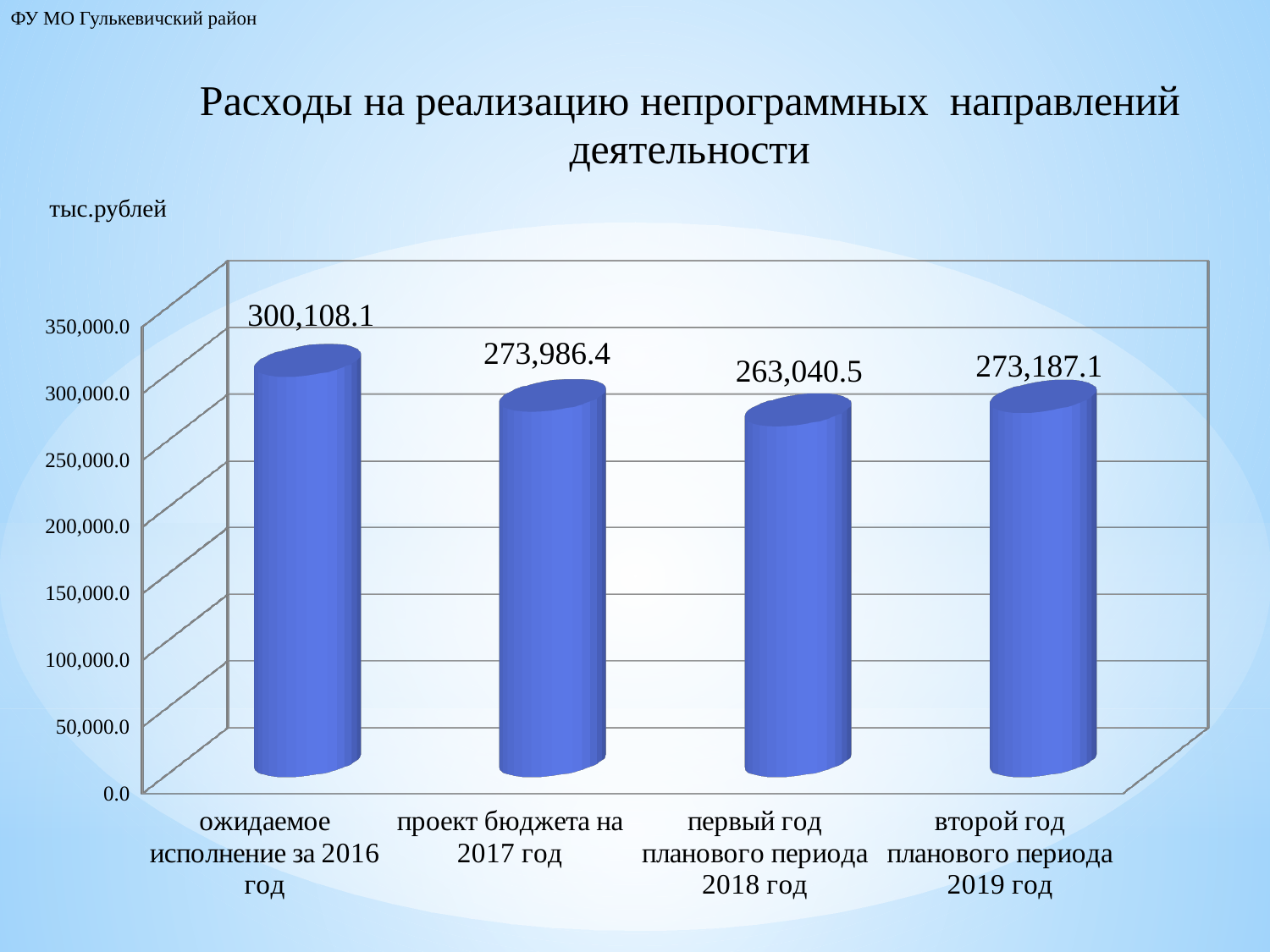
What is the value for 'проект бюджета на 2017 год'? 273,986.4 Which category has the highest value? ожидаемое исполнение за 2016 год What is the value for 'первый год планового периода 2018 год'? 263,040.5 What kind of chart is shown on the slide? bar chart Is the value for 'первый год планового периода 2018 год' greater or less than 300,000.0? less What is the value for 'ожидаемое исполнение за 2016 год'? 300,108.1 Which category has the lowest value? первый год планового периода 2018 год What is the value for 'второй год планового периода 2019 год'? 273,187.1 How many categories are shown on the chart? 4 What is the difference between the value for 2016 (ожидаемое исполнение) and the value for 2017 (проект бюджета)? 26,121.7 Which is larger: the value for 2017 (проект бюджета) or the value for 2018 (первый год планового периода)? проект бюджета на 2017 год What is the difference between the value for 2019 (второй год планового периода) and the value for 2018 (первый год планового периода)? 10,146.6